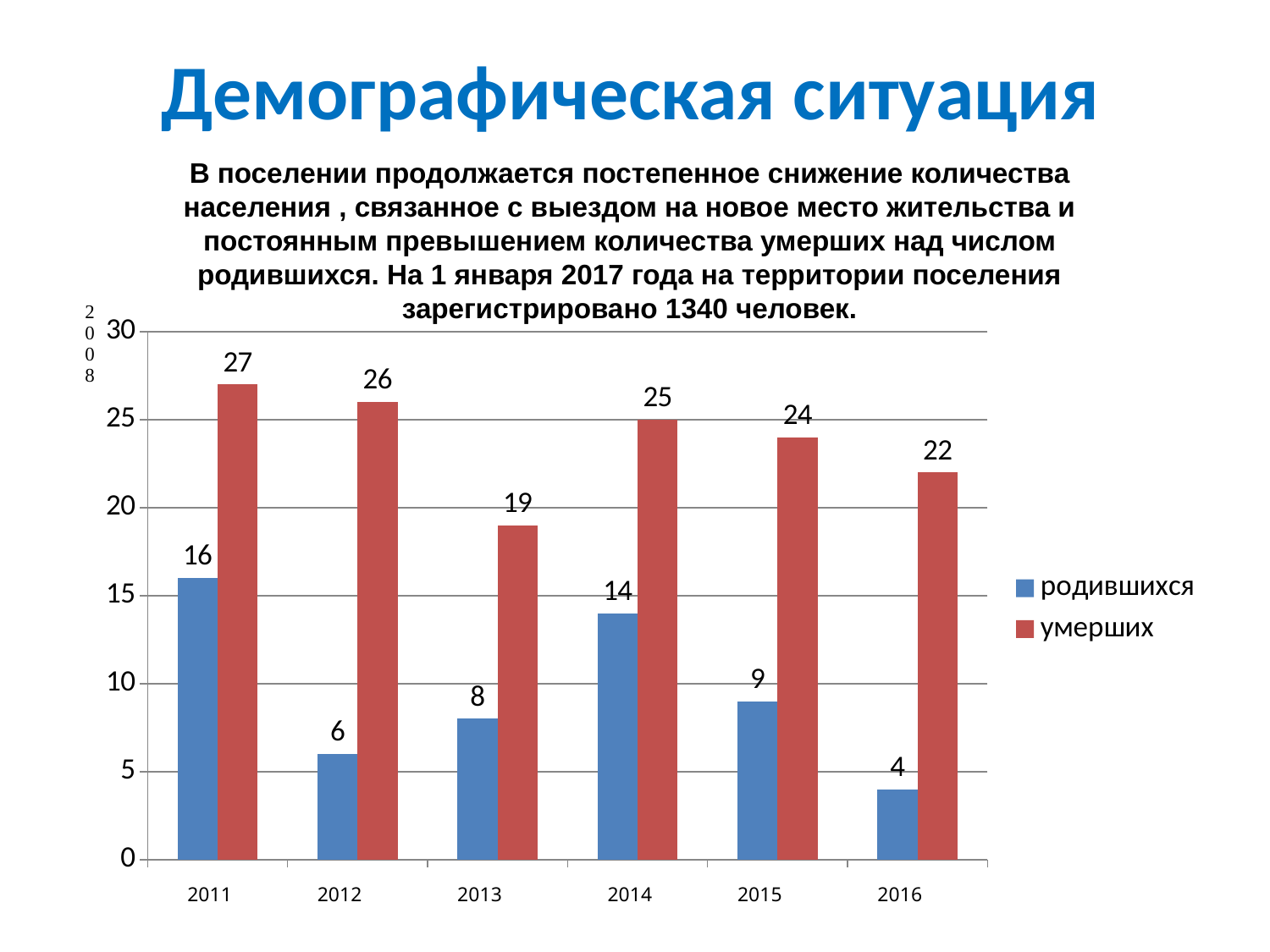
In which year is the value for родившихся lowest? 2016 What are the two legend entries of the chart? родившихся, умерших How many series does the legend list? 2 How many years are shown on the x axis? 6 In which year is the value for умерших highest? 2011 What is the value for родившихся in 2016? 4 Which is larger in 2014: родившихся or умерших? умерших What type of chart is shown on the slide? bar chart What is the difference between умерших and родившихся in 2012? 20 What is the value for родившихся in 2011? 16 What is the value for умерших in 2013? 19 Does the value for умерших rise or fall from 2014 to 2016? fall